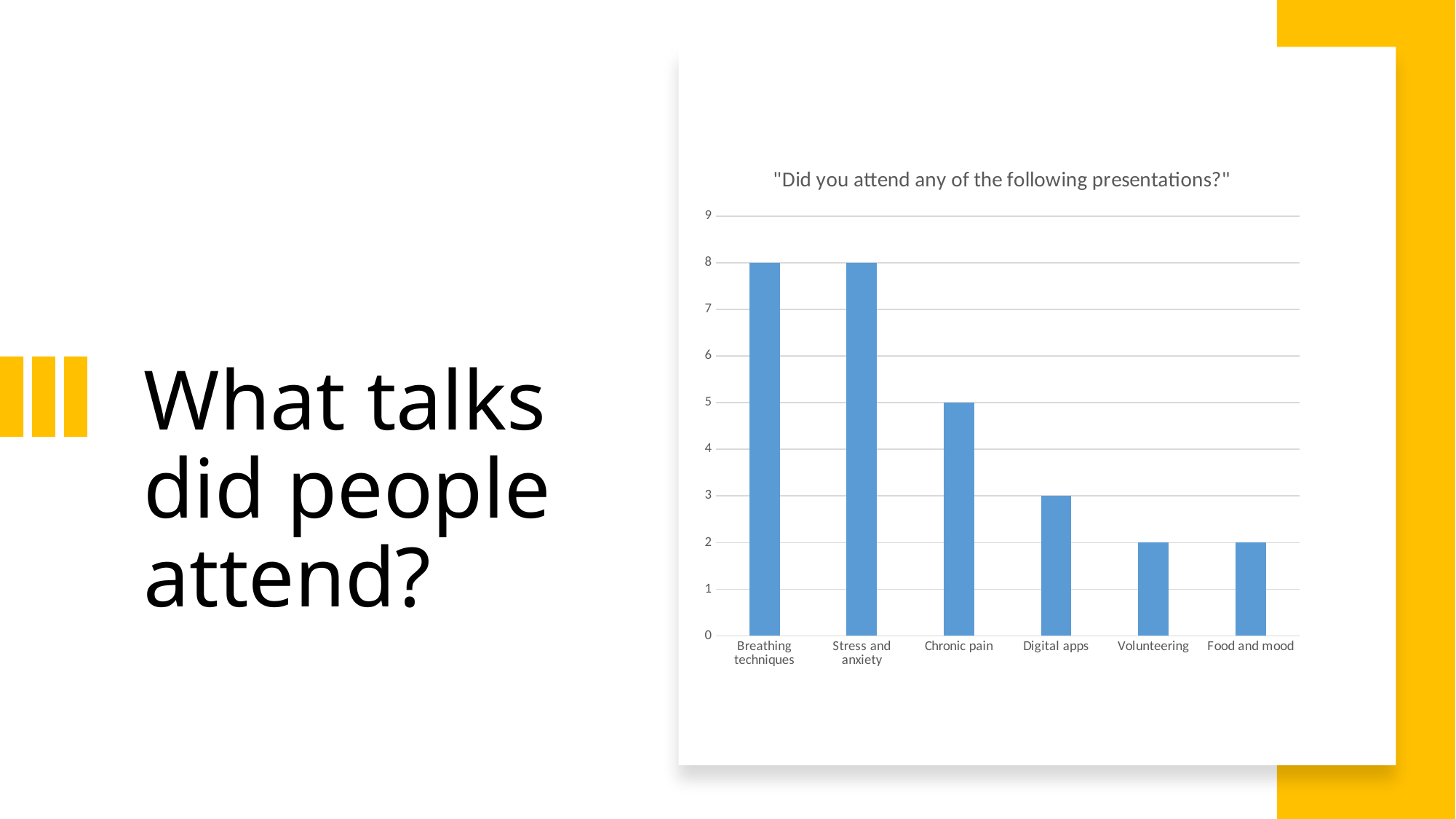
What is the value for Digital apps? 3 What is the difference between the values for Breathing techniques and Food and mood? 6 What is the value for Stress and anxiety? 8 What is the value for Chronic pain? 5 What is the value for Volunteering? 2 What kind of chart is shown on the slide? bar chart What is the value for Breathing techniques? 8 What is the title of the chart? "Did you attend any of the following presentations?" Which is larger, the value for Chronic pain or the value for Volunteering? Chronic pain Is the value for Chronic pain greater or less than 4? greater How many categories are shown on the x axis? 6 What is the difference between the values for Chronic pain and Digital apps? 2